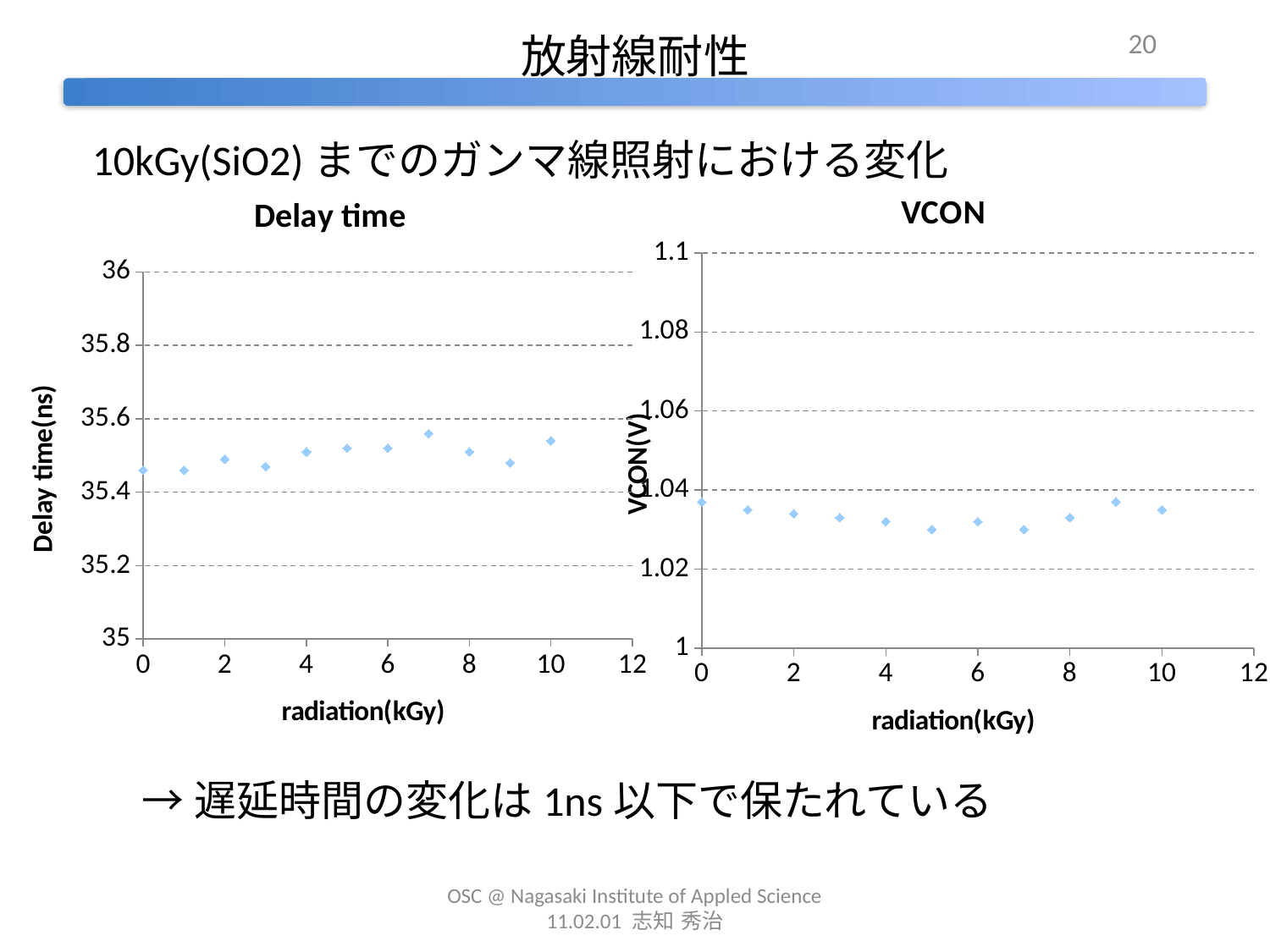
What kind of chart is the VCON chart? scatter chart What is the x-axis title of the Delay time chart? radiation(kGy) How many data points are plotted in the VCON chart? 11 In the Delay time chart, is the value at 0 kGy greater or less than 35.4? greater What kind of chart is the Delay time chart? scatter chart In the VCON chart, is the value at 0 kGy greater or less than 1.04? less In the VCON chart, is the value at 5 kGy greater or less than 1.02? greater What is the y-axis title of the VCON chart? VCON(V) How many data points are plotted in the Delay time chart? 11